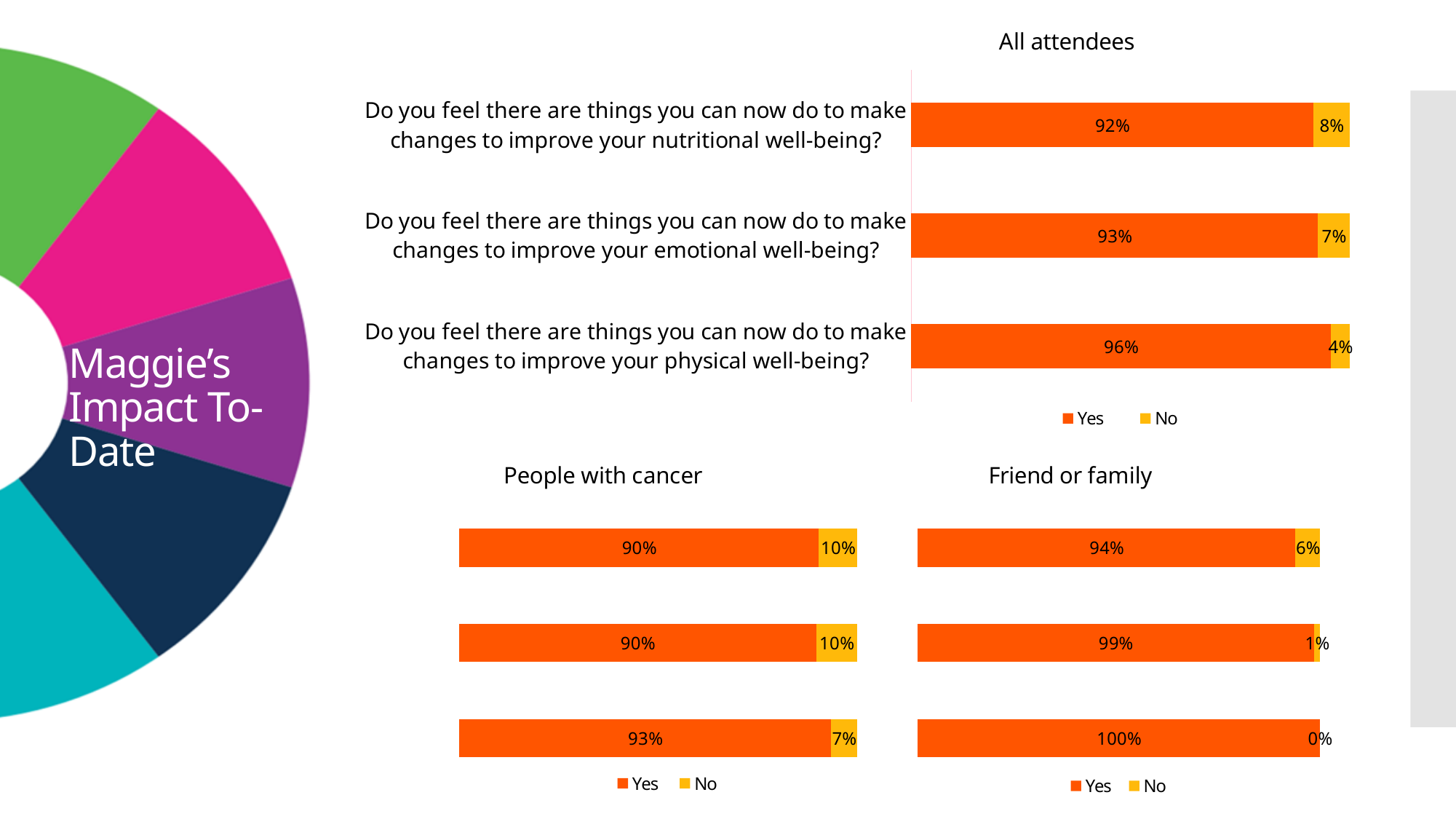
In the 'All attendees' chart, which question has the highest Yes percentage? Do you feel there are things you can now do to make changes to improve your physical well-being? In the 'Friend or family' chart, what is the No percentage on the bottom bar? 0% What type of chart is the 'Friend or family' chart? Stacked bar chart In the 'All attendees' chart, what is the difference between the Yes percentages for physical well-being and nutritional well-being? 4% How many series does the legend of the 'All attendees' chart list? 2 Is the Yes percentage on the top bar of the 'People with cancer' chart larger or smaller than the Yes percentage on the top bar of the 'Friend or family' chart? smaller In the 'All attendees' chart, what percentage answered Yes to whether there are things they can now do to improve their physical well-being? 96% In the 'All attendees' chart, what percentage answered No to whether there are things they can now do to improve their nutritional well-being? 8% In the 'People with cancer' chart, what is the No percentage on the top bar? 10% In the 'People with cancer' chart, what is the Yes percentage on the bottom bar? 93% In the 'Friend or family' chart, what is the Yes percentage on the middle bar? 99% In the 'All attendees' chart, what percentage answered Yes for emotional well-being? 93%